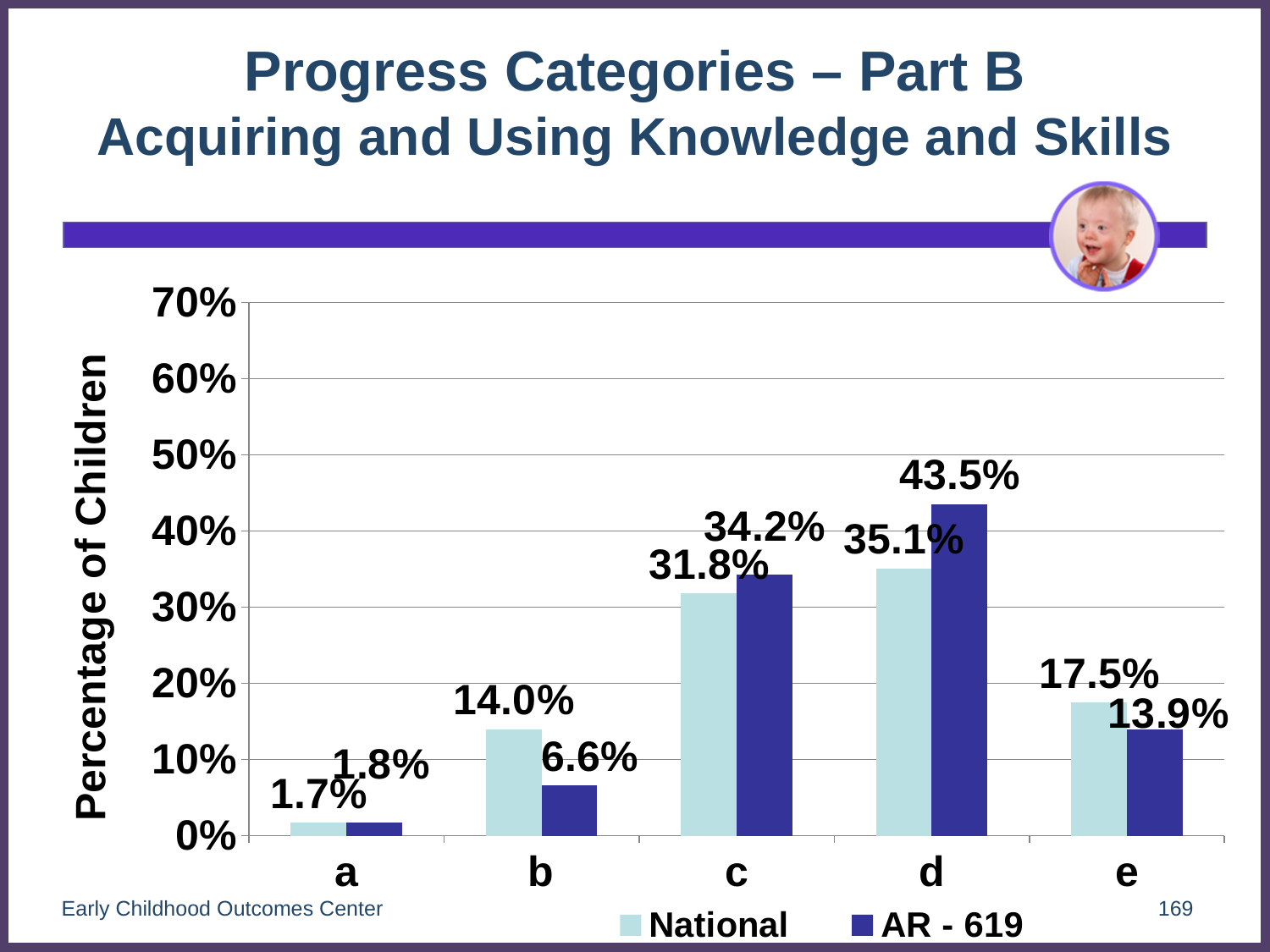
Which category has the highest AR - 619 value? d What is the AR - 619 value for category b? 6.6% What is the AR - 619 value for category c? 34.2% What is the National value for category d? 35.1% Which category has the lowest National value? a What is the difference between the National and AR - 619 values for category b? 7.4% What is the difference between the AR - 619 and National values for category d? 8.4% How many series does the legend list? 2 What kind of chart is shown on the slide? bar chart How many categories are shown on the x axis? 5 For category e, which is larger, the National value or the AR - 619 value? National Is the AR - 619 value for category d greater or less than 40%? greater